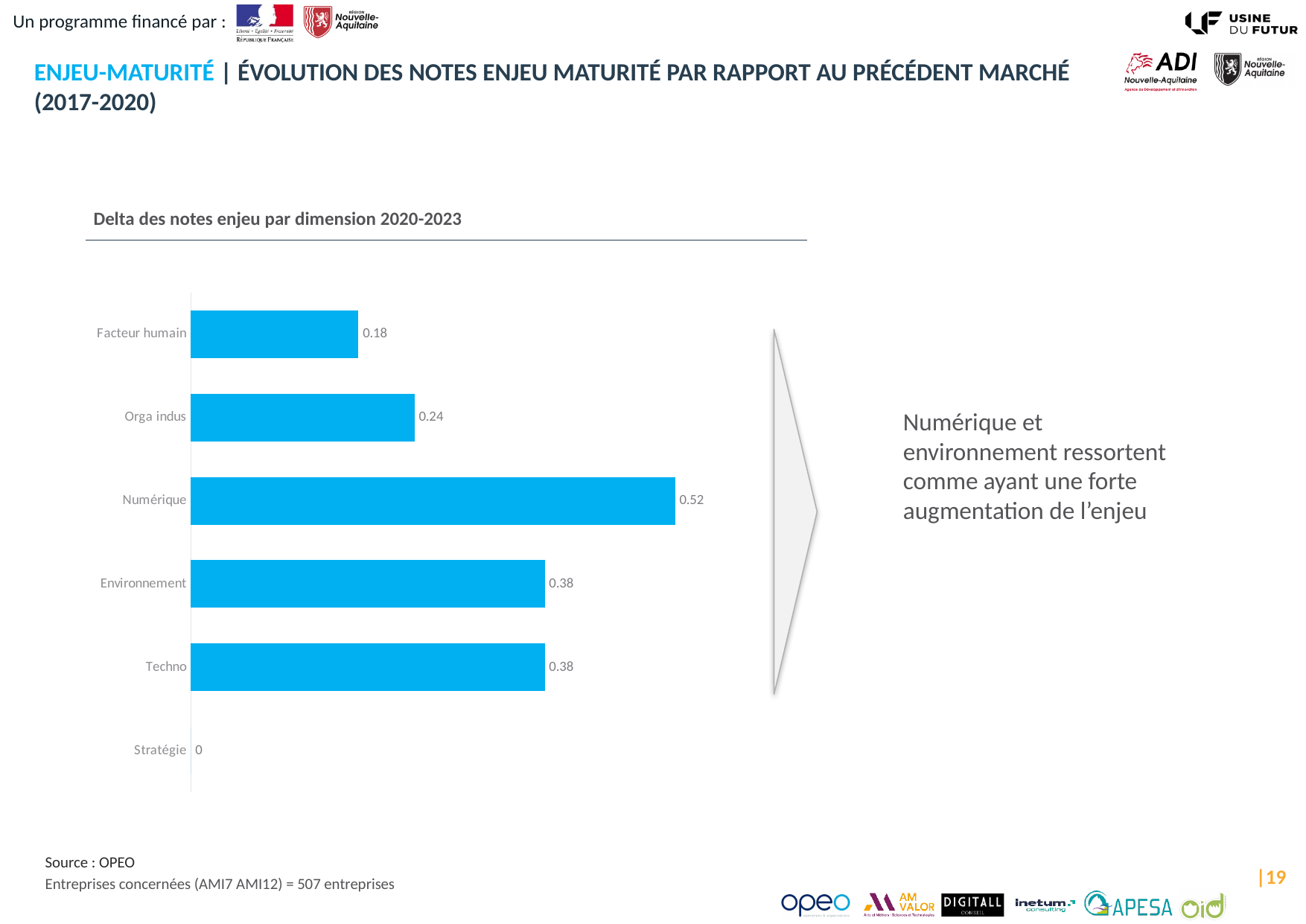
What is the difference between the values for Orga indus and Facteur humain? 0.06 What is the difference between the values for Numérique and Environnement? 0.14 What is the value for Facteur humain? 0.18 Which dimension has the highest value? Numérique How many dimensions are shown in the chart? 6 Which dimension has the lowest value? Stratégie What is the value for Numérique? 0.52 What kind of chart is shown on the slide? Bar chart What is the title of the chart? Delta des notes enjeu par dimension 2020-2023 What is the value for Stratégie? 0 Which is larger, the value for Techno or the value for Orga indus? Techno What is the value for Orga indus? 0.24